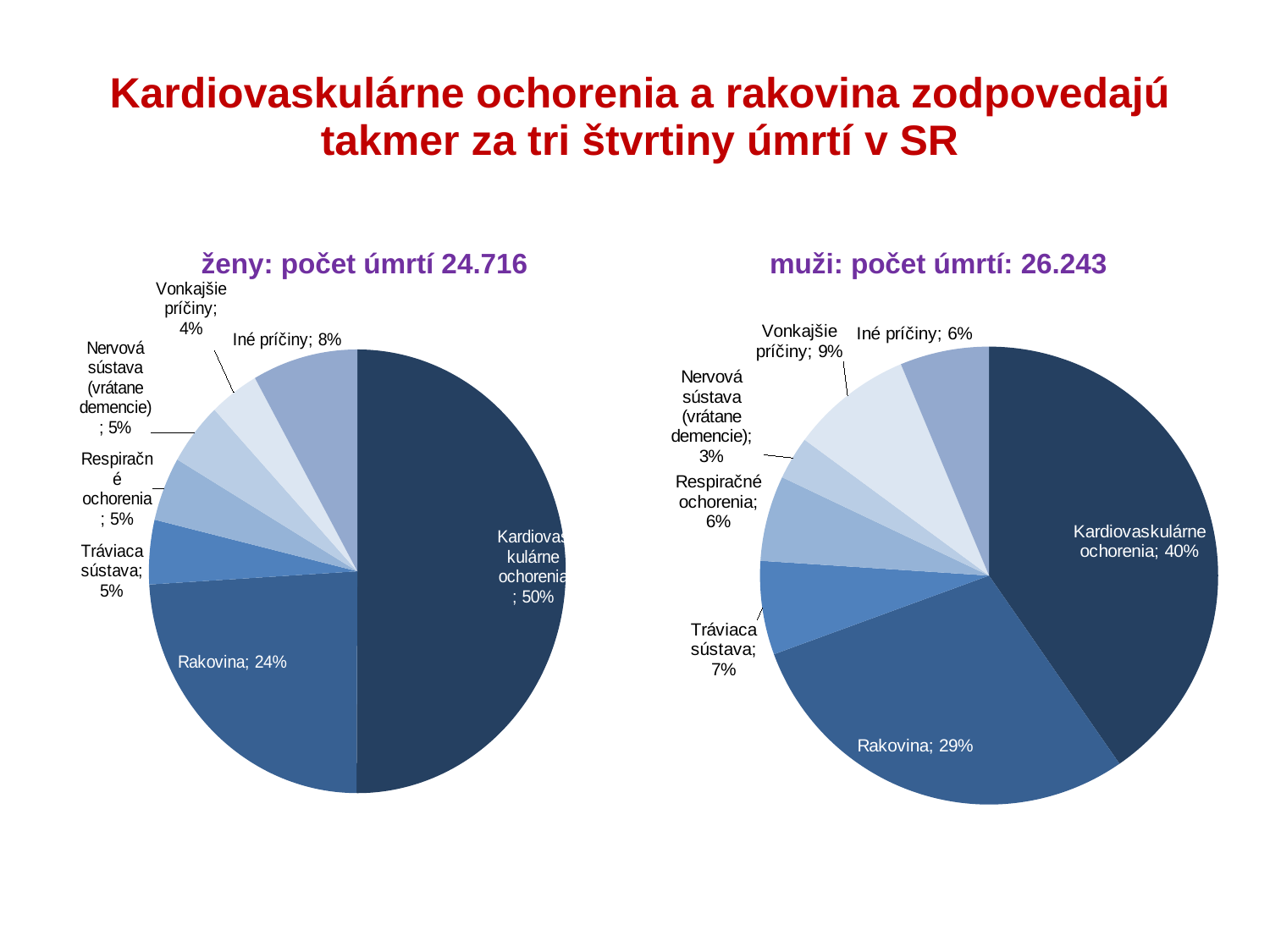
In the chart titled 'ženy: počet úmrtí 24.716', what is the difference between the shares for Kardiovaskulárne ochorenia and Rakovina? 26% What is the title of the chart on the right side of the slide? muži: počet úmrtí: 26.243 How many categories does the chart titled 'muži: počet úmrtí: 26.243' show? 7 In the chart titled 'ženy: počet úmrtí 24.716', which category has the largest share? Kardiovaskulárne ochorenia What kind of chart is the chart titled 'ženy: počet úmrtí 24.716'? pie chart Which is larger: the share for Vonkajšie príčiny in the 'ženy' chart or in the 'muži' chart? muži In the chart titled 'muži: počet úmrtí: 26.243', what is the difference between the shares for Kardiovaskulárne ochorenia and Rakovina? 11% In the chart titled 'muži: počet úmrtí: 26.243', what is the value for Vonkajšie príčiny? 9% In the chart titled 'muži: počet úmrtí: 26.243', which category has the smallest share? Nervová sústava (vrátane demencie) In the chart titled 'muži: počet úmrtí: 26.243', what share of deaths is attributed to Rakovina? 29% In the chart titled 'ženy: počet úmrtí 24.716', what is the value for Iné príčiny? 8% In the chart titled 'ženy: počet úmrtí 24.716', what share of deaths is attributed to Kardiovaskulárne ochorenia? 50%